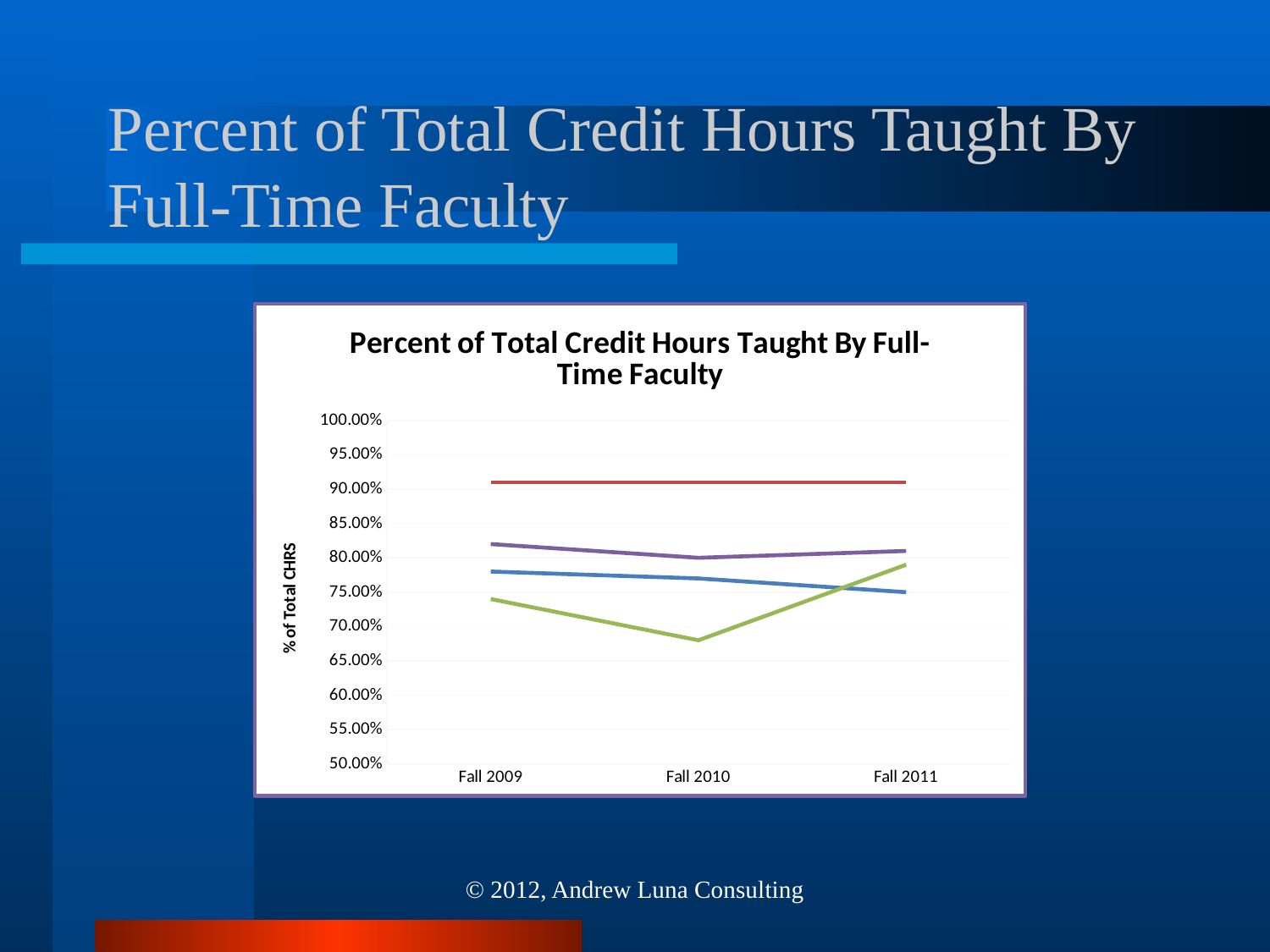
Does the blue line rise or fall from Fall 2009 to Fall 2011? fall What is the label on the vertical axis of the chart? % of Total CHRS At Fall 2011, which is higher: the green line or the blue line? the green line Which coloured line is the highest across all three terms? the red line Is the value of the red line at Fall 2009 greater or less than 85.00%? greater How many time points are shown on the x axis of the chart? 3 Is the value of the green line at Fall 2010 greater or less than 70.00%? less What kind of chart is shown on the slide? line chart What is the title of the chart? Percent of Total Credit Hours Taught By Full-Time Faculty Is the value of the blue line at Fall 2011 greater or less than 80.00%? less Which coloured line is the lowest at Fall 2010? the green line